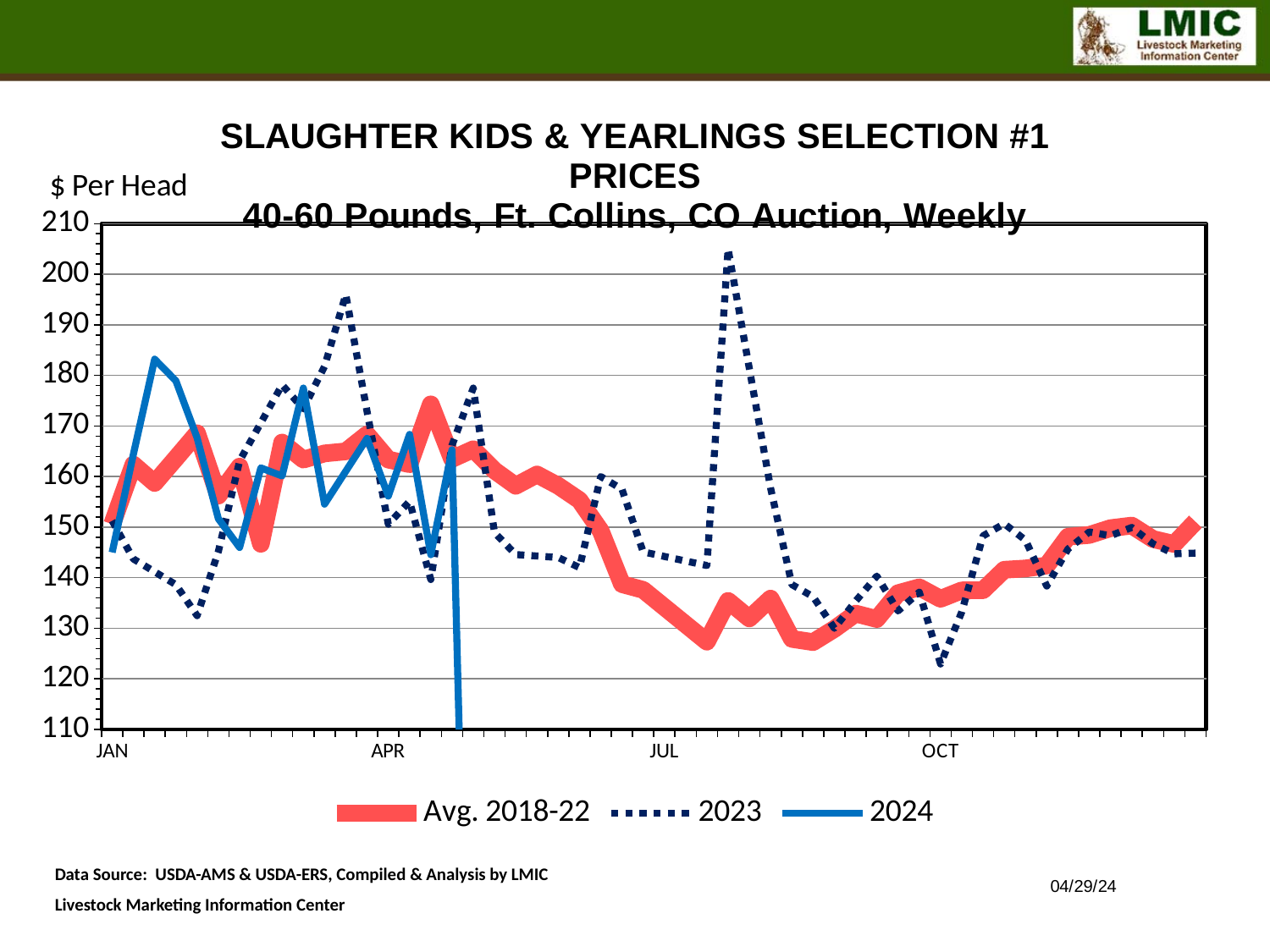
In August, which series is higher: 2023 or Avg. 2018-22? 2023 What kind of chart is shown on the slide? line chart What unit label is shown above the y axis? $ Per Head How many series does the legend list? 3 Which series reaches the highest value anywhere on the chart? 2023 How many month labels are shown along the x axis? 4 Is the lowest value of the Avg. 2018-22 series, around September, greater or less than 130? less What are the three series named in the legend? Avg. 2018-22, 2023, 2024 Is the peak value of the 2023 series in August greater or less than 200? greater Is the lowest value of the 2023 series, around October, greater or less than 130? less Does the Avg. 2018-22 series rise or fall between April and September? fall